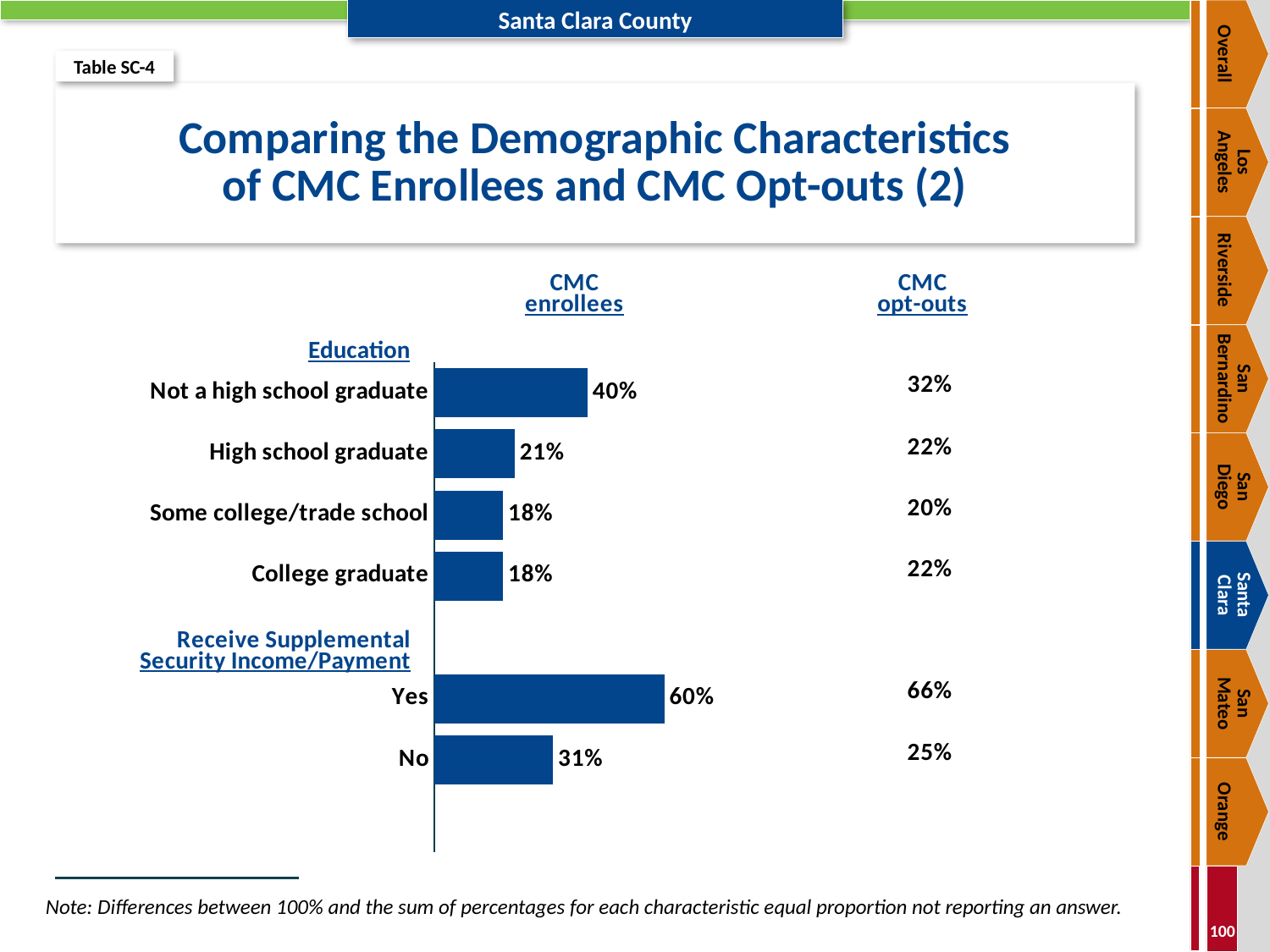
What is the title of the chart on the slide? Comparing the Demographic Characteristics of CMC Enrollees and CMC Opt-outs (2) Which education category has the lowest percentage among CMC opt-outs? Some college/trade school What percentage of CMC enrollees are not a high school graduate? 40% What percentage of CMC enrollees receive Supplemental Security Income/Payment (Yes)? 60% What type of chart is used to show the CMC enrollees percentages? Bar chart How many education categories are shown in the chart? 4 What percentage of CMC opt-outs answered No to receiving Supplemental Security Income/Payment? 25% Which education category has the highest percentage among CMC enrollees? Not a high school graduate What percentage of CMC opt-outs are college graduates? 22% What is the difference between the CMC enrollees and CMC opt-outs percentages for 'Not a high school graduate'? 8 percentage points Which is larger: the CMC enrollees percentage or the CMC opt-outs percentage for 'Yes' on receiving Supplemental Security Income/Payment? CMC opt-outs What is the difference between the Yes and No percentages for CMC enrollees receiving Supplemental Security Income/Payment? 29 percentage points